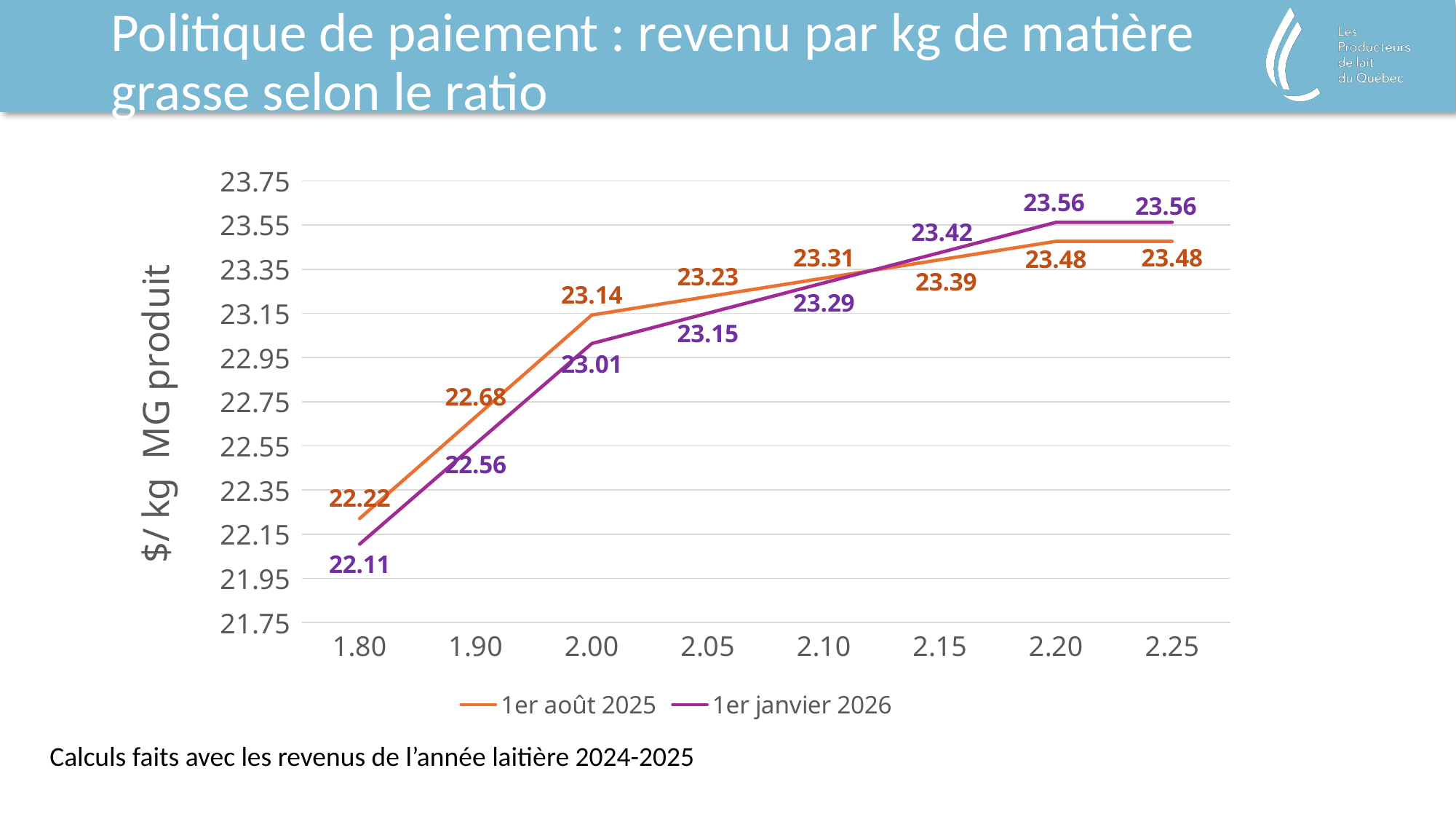
What is the value for the 1er janvier 2026 series at ratio 1.80? 22.11 At ratio 2.20, which series has the larger value, 1er août 2025 or 1er janvier 2026? 1er janvier 2026 What type of chart is shown on the slide? line chart What is the value for the 1er janvier 2026 series at ratio 2.15? 23.42 What is the value for the 1er août 2025 series at ratio 2.00? 23.14 Do the values of the 1er janvier 2026 series rise or fall as the ratio increases from 1.80 to 2.20? rise How many series does the legend list? 2 How many ratio values are plotted along the x axis? 8 At which ratio is the 1er août 2025 series lowest? 1.80 What is the difference between the 1er août 2025 and 1er janvier 2026 values at ratio 1.90? 0.12 What is the highest value reached by the 1er janvier 2026 series? 23.56 What is the label of the y axis? $/ kg MG produit